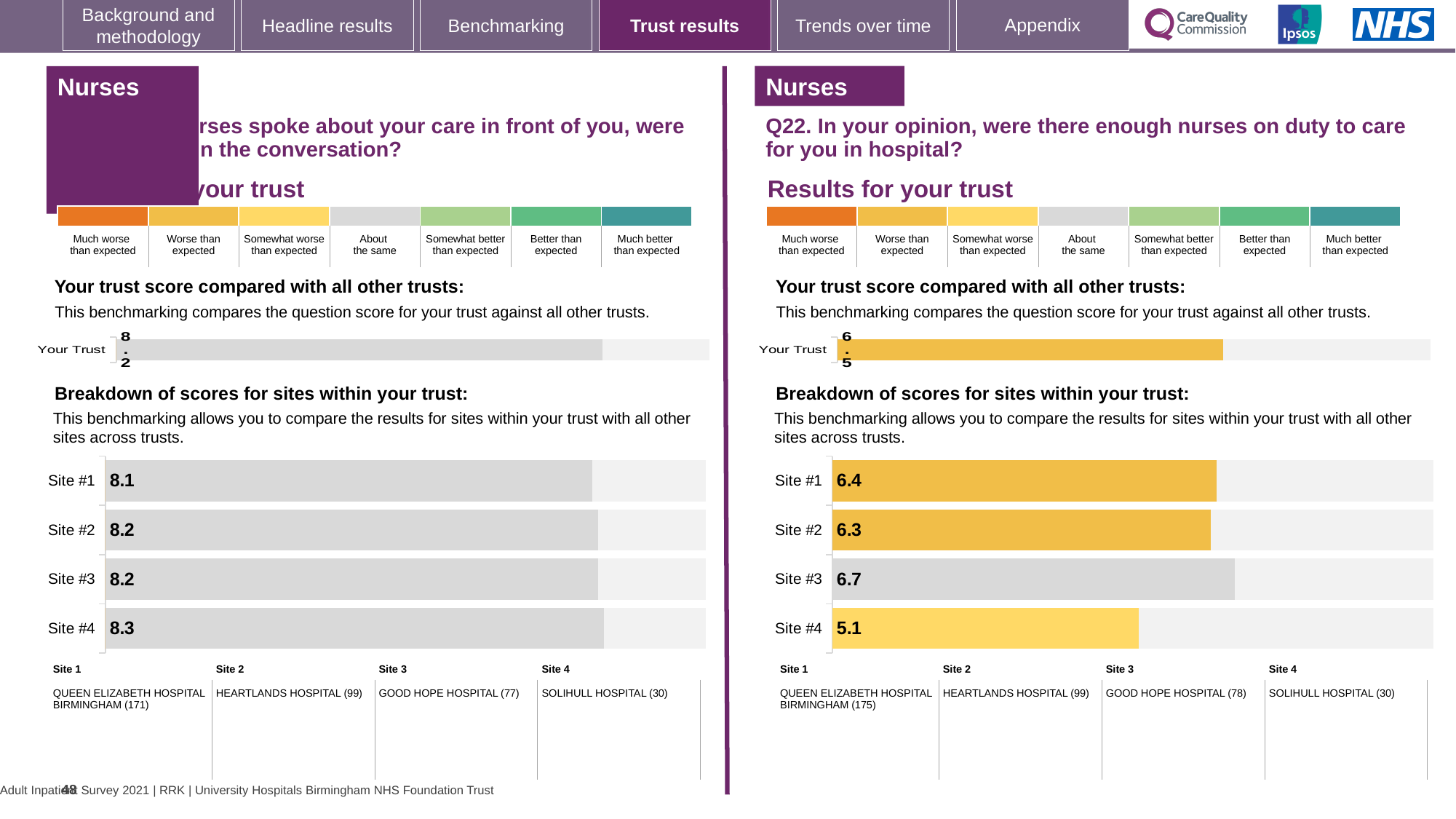
On the right-hand slide (Q22), which has the larger score in the site breakdown chart, Site #1 or Site #2? Site #1 On the right-hand slide (Q22), what is the score for Site #3 in the breakdown of scores for sites within your trust? 6.7 On the right-hand slide (Q22), what is the difference between the scores for Site #3 and Site #4 in the site breakdown chart? 1.6 On the right-hand slide (Q22), what is the score shown for Your Trust in the trust score comparison chart? 6.5 On the right-hand slide (Q22), which site has the lowest score in the breakdown of scores for sites within your trust? Site #4 On the left-hand slide, what is the score shown for Your Trust in the trust score comparison chart? 8.2 On the right-hand slide (Q22), which site has the highest score in the breakdown of scores for sites within your trust? Site #3 What type of chart is used for the breakdown of scores for sites within your trust on the left-hand slide? Bar chart On the left-hand slide, which site has the highest score in the breakdown of scores for sites within your trust? Site #4 On the left-hand slide, what is the score for Site #1 in the breakdown of scores for sites within your trust? 8.1 How many sites are shown in the breakdown of scores chart on the right-hand slide (Q22)? 4 On the left-hand slide, what is the difference between the scores for Site #4 and Site #1 in the site breakdown chart? 0.2